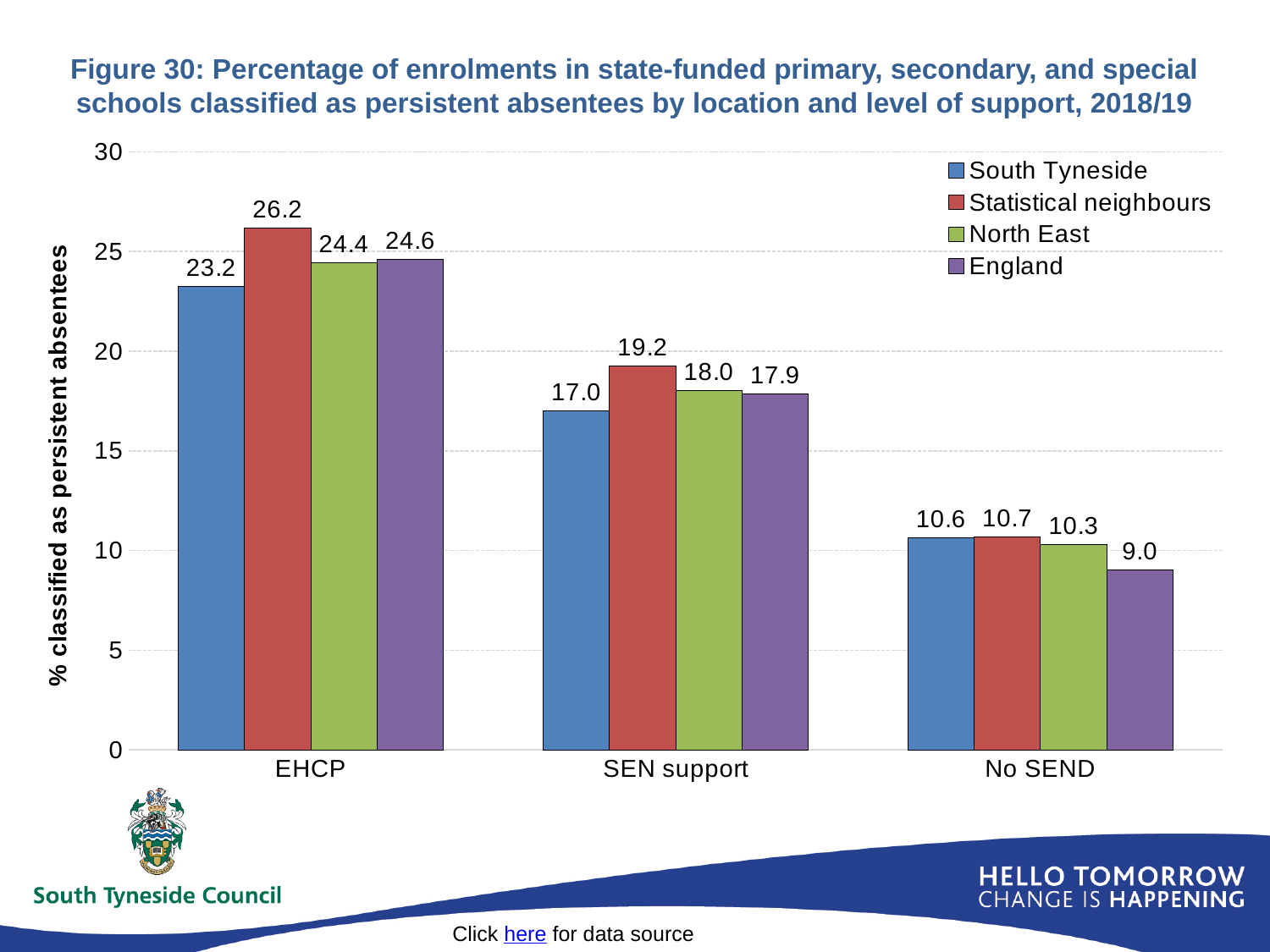
What is the value for Statistical neighbours in the SEN support category? 19.2 What is the value for South Tyneside in the EHCP category? 23.2 What is the value for England in the No SEND category? 9.0 How many series does the legend list? 4 Which series has the highest value in the EHCP category? Statistical neighbours What is the difference between the Statistical neighbours and South Tyneside values in the EHCP category? 3.0 Which series has the lowest value in the SEN support category? South Tyneside What kind of chart is shown on the slide? Bar chart Do the South Tyneside values rise or fall from EHCP to No SEND? Fall What is the label of the y axis? % classified as persistent absentees How many categories are shown on the x axis? 3 Which is larger in the No SEND category: North East or England? North East